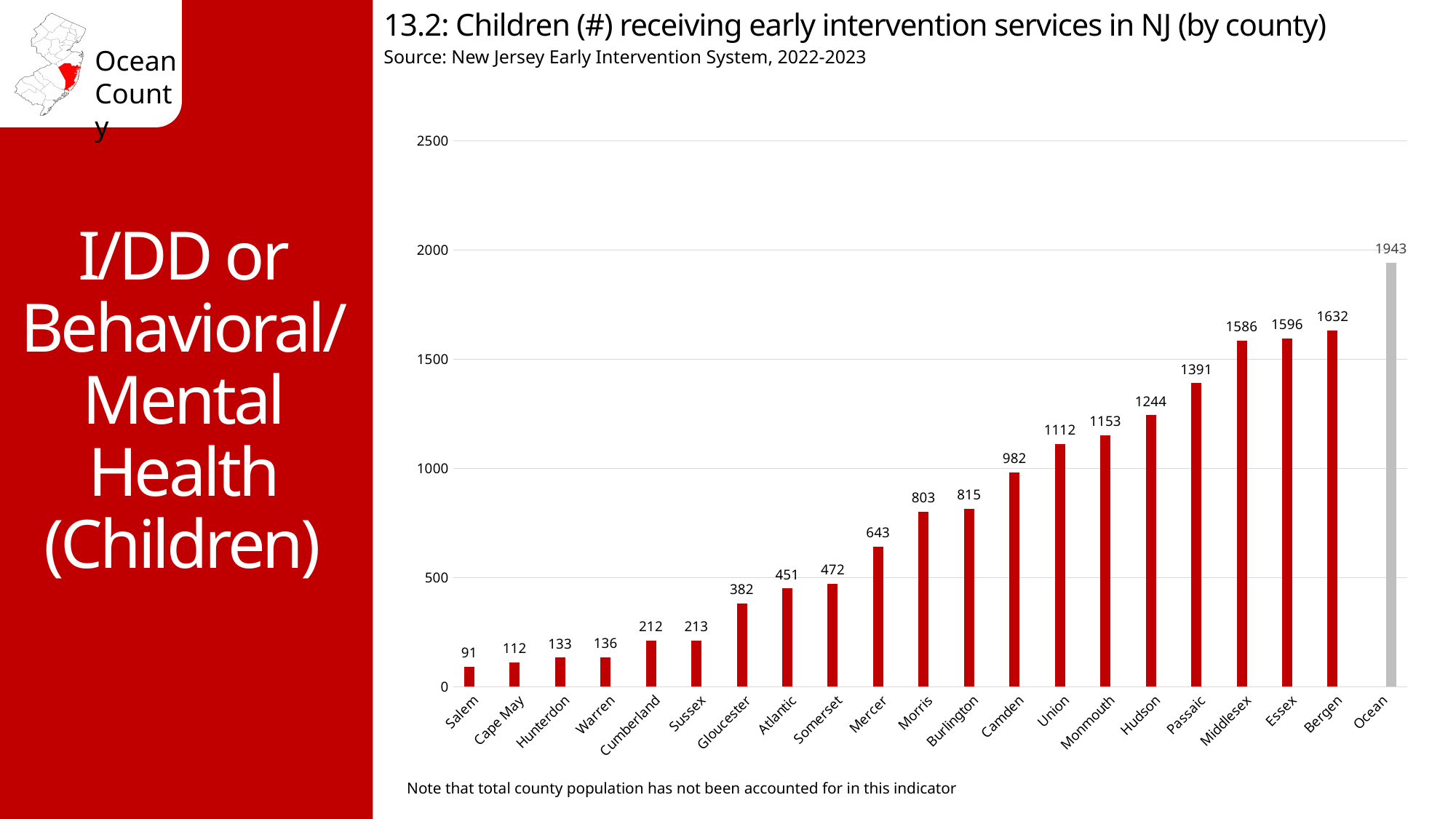
How many counties are shown on the chart? 21 What is the difference between the values for Camden and Burlington? 167 Which county has the lowest number of children receiving early intervention services? Salem What is the value shown for Mercer County? 643 What is the value shown for Hudson County? 1244 Which county has the highest number of children receiving early intervention services? Ocean What is the difference between the values for Ocean and Bergen? 311 What kind of chart is shown on the slide? Bar chart Which county's bar is shown in grey rather than red? Ocean How many children are receiving early intervention services in Ocean County? 1943 Which county has a larger value, Passaic or Monmouth? Passaic Is the value for Union County greater or less than 1000? greater